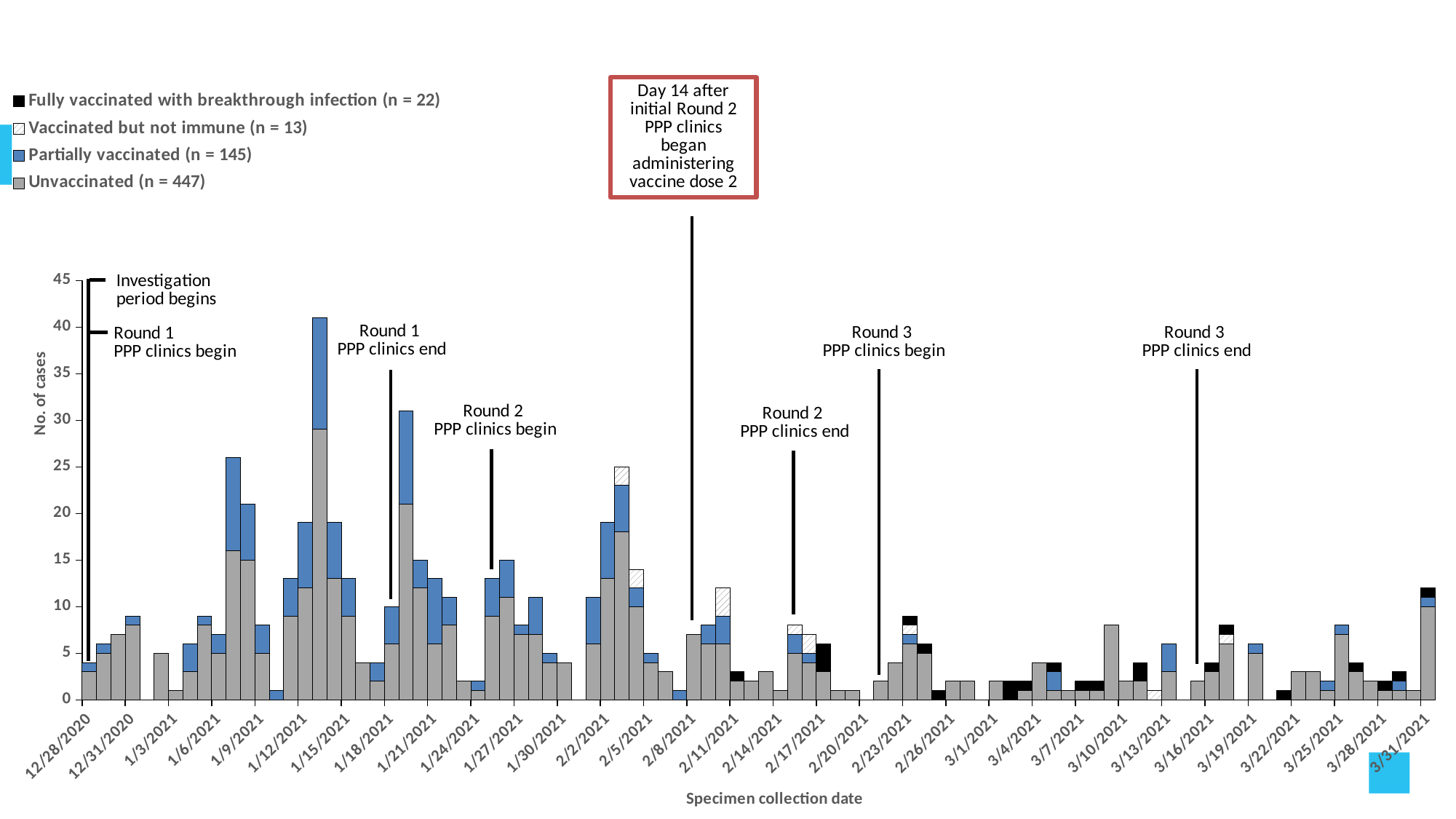
Is the total number of cases for 2/8/2021 greater or less than 5? greater Is the total number of cases for 12/28/2020 greater or less than 5? less Is the total number of cases for 3/31/2021 greater or less than 10? greater According to the legend, how many cases were unvaccinated? 447 Which date has more total cases, 2/8/2021 or 12/28/2020? 2/8/2021 What is the title of the x axis? Specimen collection date What kind of chart is shown on the slide? Stacked bar chart How many series does the legend list? 4 Which date has more total cases, 12/28/2020 or 3/31/2021? 3/31/2021 Do the daily case counts generally rise or fall from mid-January 2021 to late March 2021? fall